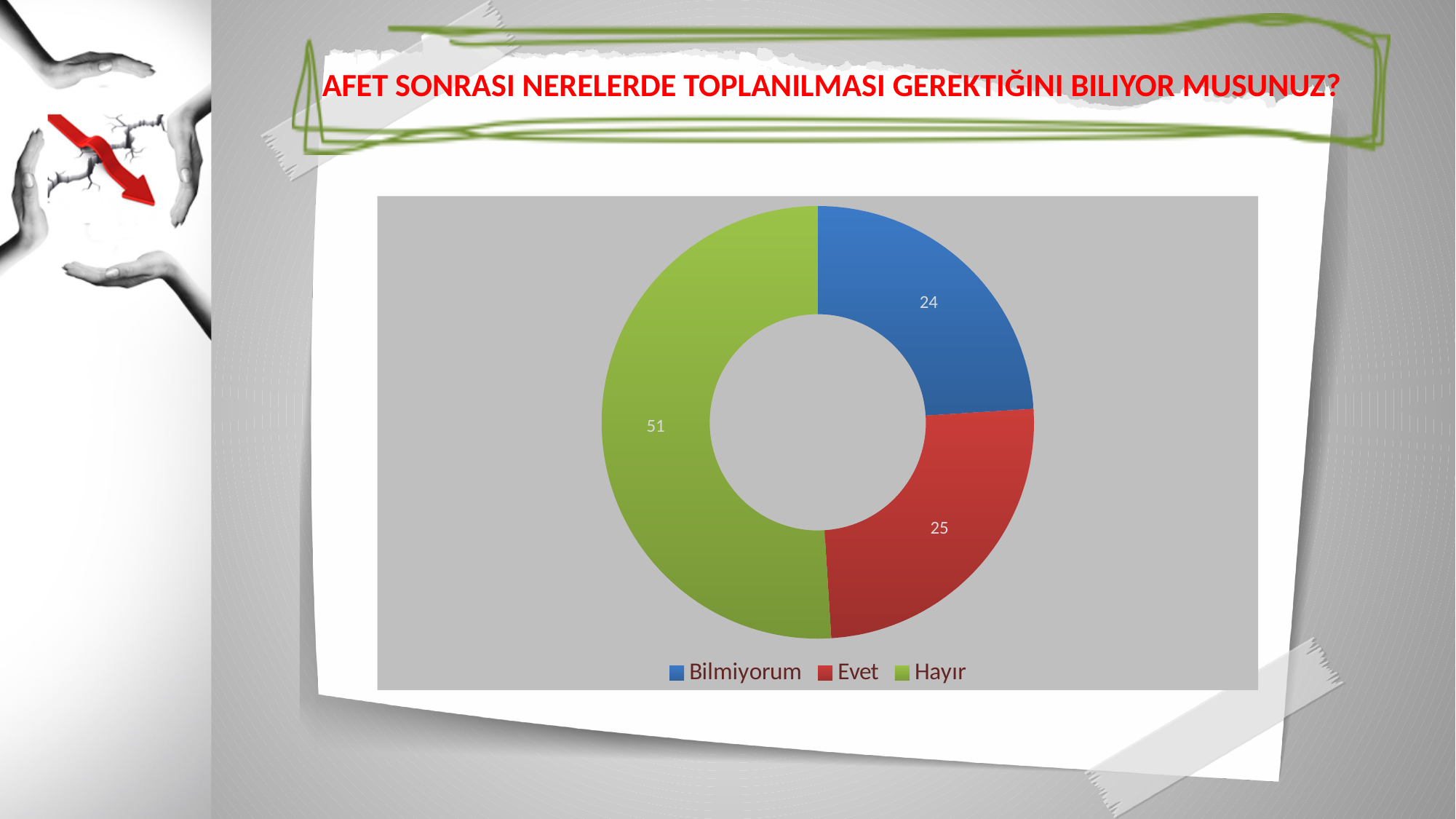
Which category has the largest slice? Hayır What share of the whole does the Hayır slice represent? 51% Which category has the smallest slice? Bilmiyorum What kind of chart is shown on the slide? doughnut chart Which is larger, the Hayır slice or the Evet slice? Hayır What value is shown for the Bilmiyorum slice? 24 What value is shown for the Evet slice? 25 What colour is the Evet slice? red What value is shown for the Hayır slice? 51 What is the difference between the Hayır value and the Evet value? 26 How many categories does the chart show? 3 How many entries does the legend list? 3